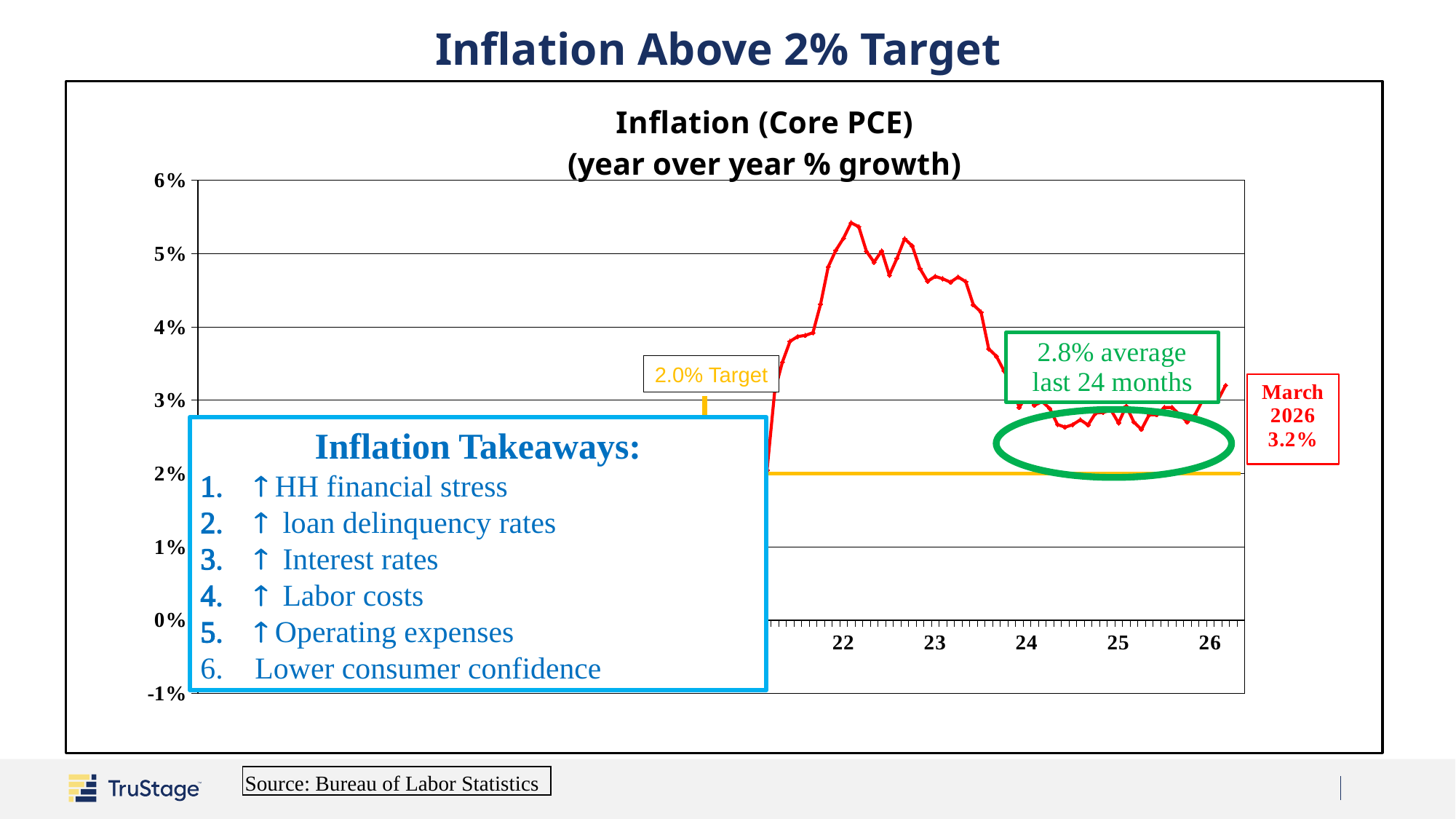
What is the title of the chart? Inflation (Core PCE) (year over year % growth) Does the line rise or fall between its 2022 peak and 2024? fall By how many percentage points does the March 2026 value exceed the 2.0% target? 1.2 percentage points By how many percentage points is the March 2026 value above the 2.8% average of the last 24 months? 0.4 percentage points What is the highest value shown on the y axis? 6% Is the peak value of the line in 2022 greater or less than 5%? greater What is the average Core PCE inflation over the last 24 months, as annotated on the chart? 2.8% What inflation target is marked on the chart? 2.0% How many year labels are shown on the x axis? 5 Which is larger: the March 2026 inflation value or the 2.0% target? March 2026 value What is the Core PCE inflation value labelled for March 2026? 3.2% What kind of chart is shown on the slide? line chart